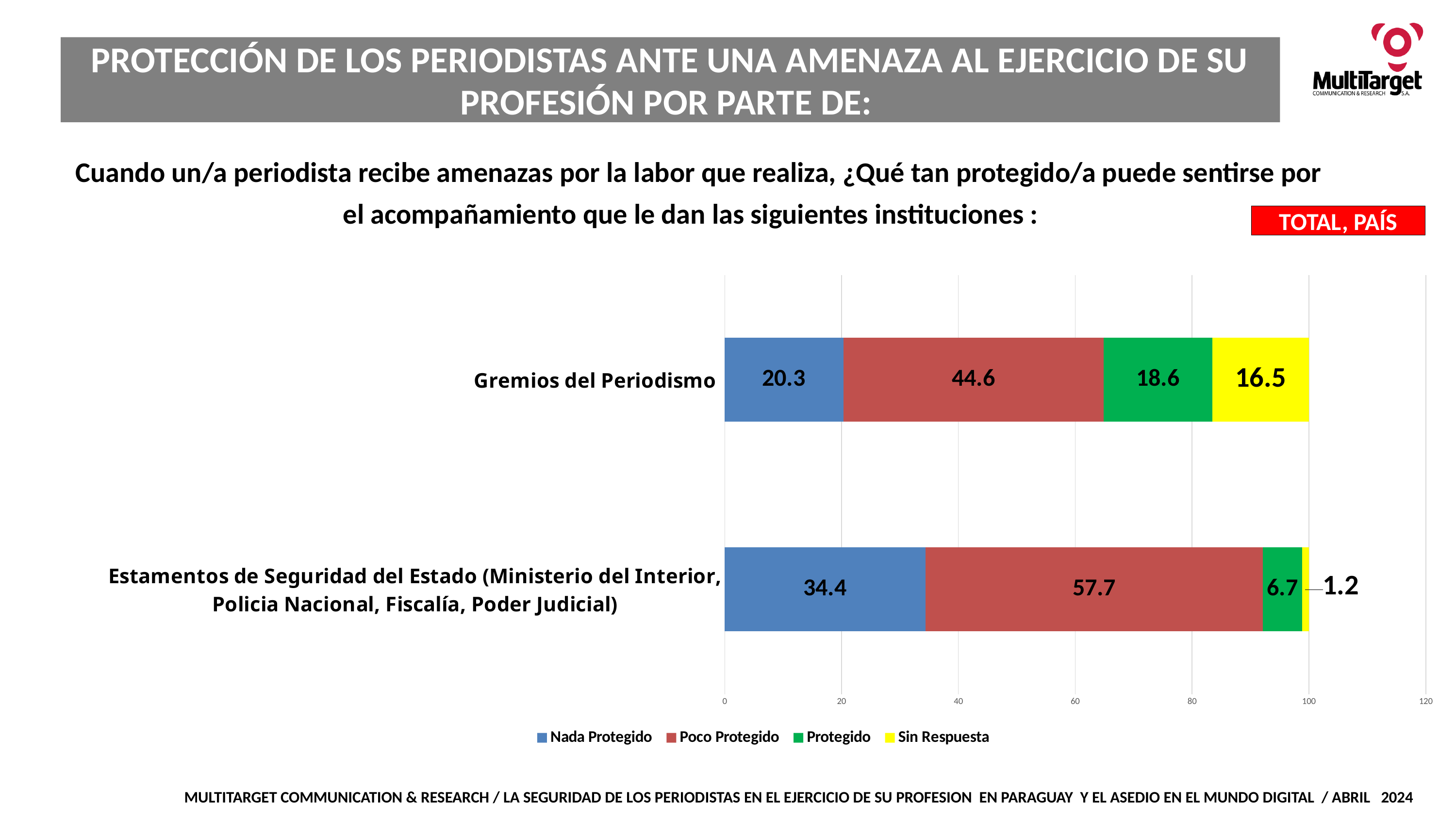
How many categories are shown on the chart? 2 What kind of chart is shown on the slide? Stacked bar chart What is the value for Poco Protegido for Gremios del Periodismo? 44.6 What is the value for Nada Protegido for Estamentos de Seguridad del Estado (Ministerio del Interior, Policia Nacional, Fiscalía, Poder Judicial)? 34.4 Which is larger: Sin Respuesta for Gremios del Periodismo or Protegido for Gremios del Periodismo? Protegido for Gremios del Periodismo How many series does the legend list? 4 Which colour represents Sin Respuesta in the legend? Yellow Which category has the higher Poco Protegido value? Estamentos de Seguridad del Estado (Ministerio del Interior, Policia Nacional, Fiscalía, Poder Judicial) What is the value for Protegido for Gremios del Periodismo? 18.6 Which category has the lower Protegido value? Estamentos de Seguridad del Estado (Ministerio del Interior, Policia Nacional, Fiscalía, Poder Judicial) What is the value for Sin Respuesta for Estamentos de Seguridad del Estado? 1.2 What is the difference between the Nada Protegido values for Estamentos de Seguridad del Estado and Gremios del Periodismo? 14.1